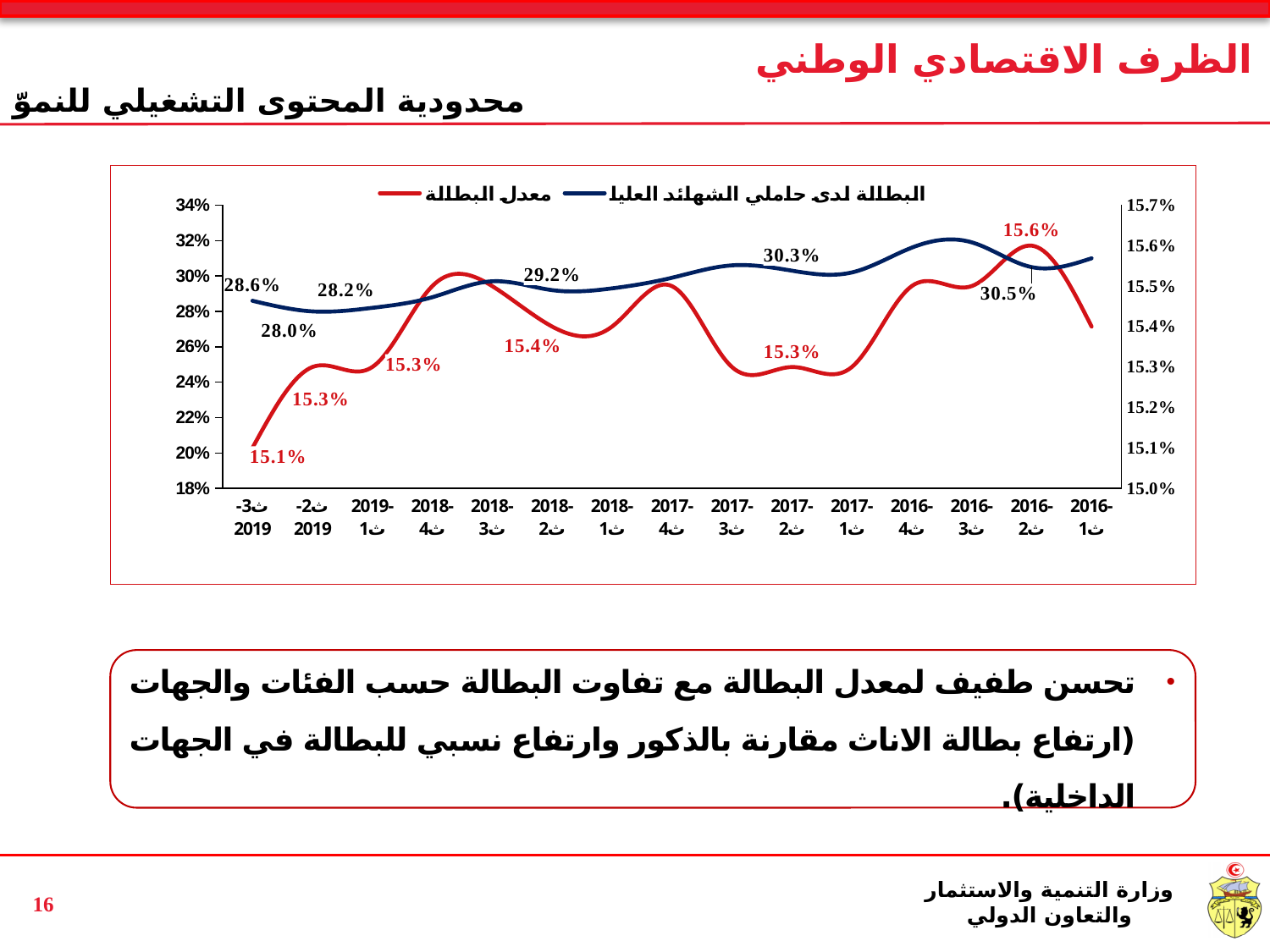
What is the difference between the graduate unemployment values labelled for 2016-ث2 (30.5%) and ث3-2019 (28.6%)? 1.9 percentage points How many series does the chart legend list? 2 What is the value of البطالة لدى حاملي الشهائد العليا (graduate unemployment) for 2018-ث2? 29.2% How many quarterly categories are shown on the x axis of the chart? 15 Among the labelled values of معدل البطالة, which quarter has the lowest value? ث3-2019 (15.1%) What is the value of البطالة لدى حاملي الشهائد العليا (graduate unemployment) for ث3-2019? 28.6% What is the value of معدل البطالة (unemployment rate) for ث3-2019? 15.1% Is the graduate unemployment value for 2016-ث3 greater or less than 30%? greater What is the value of معدل البطالة (unemployment rate) for 2016-ث2? 15.6% Which colour is used for the معدل البطالة series in the chart? Red Among the labelled values of معدل البطالة, which quarter has the highest value? 2016-ث2 (15.6%) What kind of chart is shown on the slide? Line chart